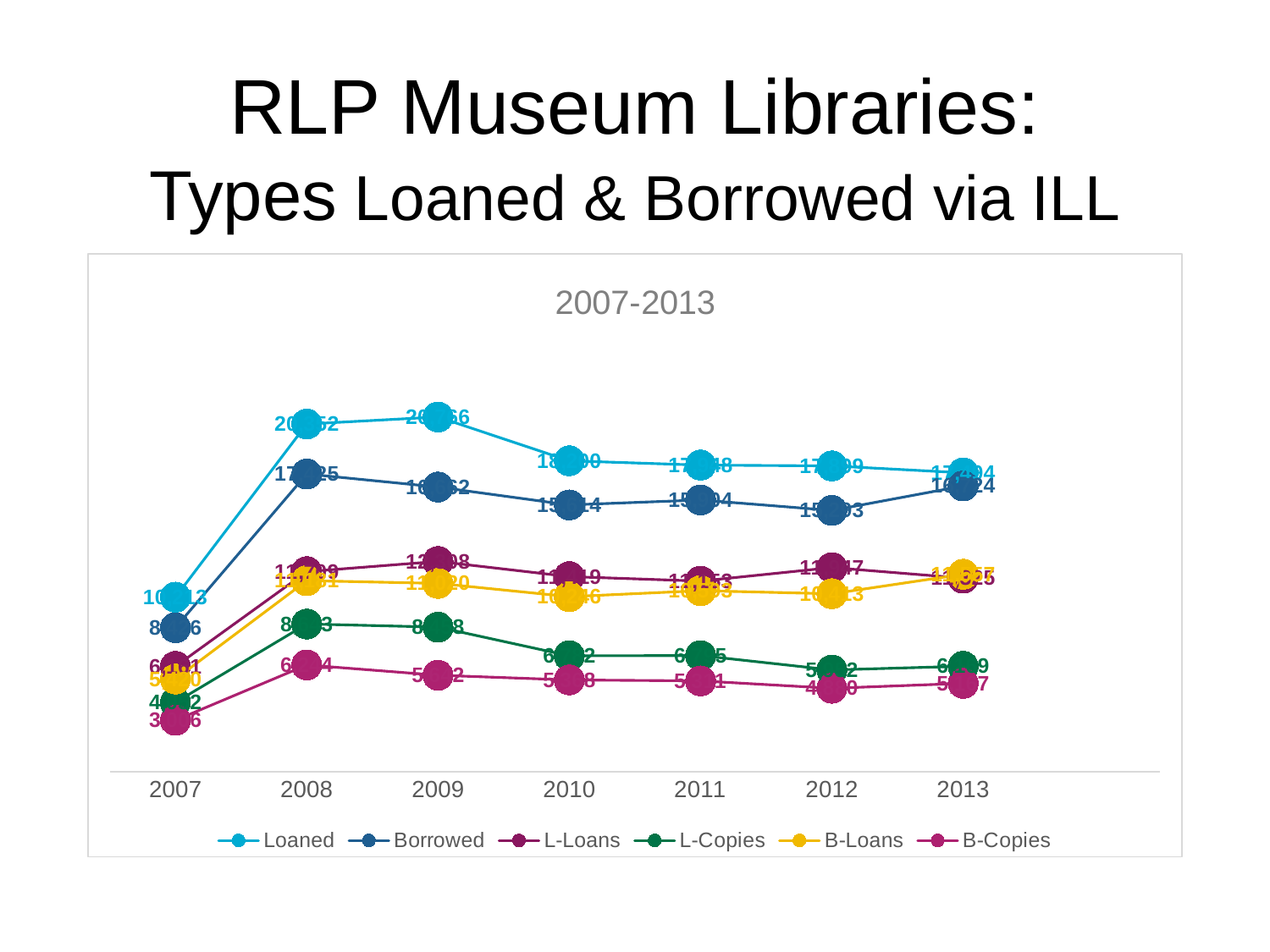
In 2009, which is larger, L-Loans or B-Loans? L-Loans In 2007, which is larger, Loaned or Borrowed? Loaned Which series has the highest values across the chart? Loaned What kind of chart is shown on the slide? line chart What subtitle is shown above the chart's plot area? 2007-2013 How many series does the legend list? 6 In which year is the Borrowed series at its lowest? 2007 Does the L-Copies series rise or fall from 2009 to 2010? fall Which series has the lowest value in 2007? B-Copies In which year is the Loaned series at its lowest? 2007 Does the Loaned series rise or fall from 2007 to 2008? rise How many years are plotted along the x axis? 7